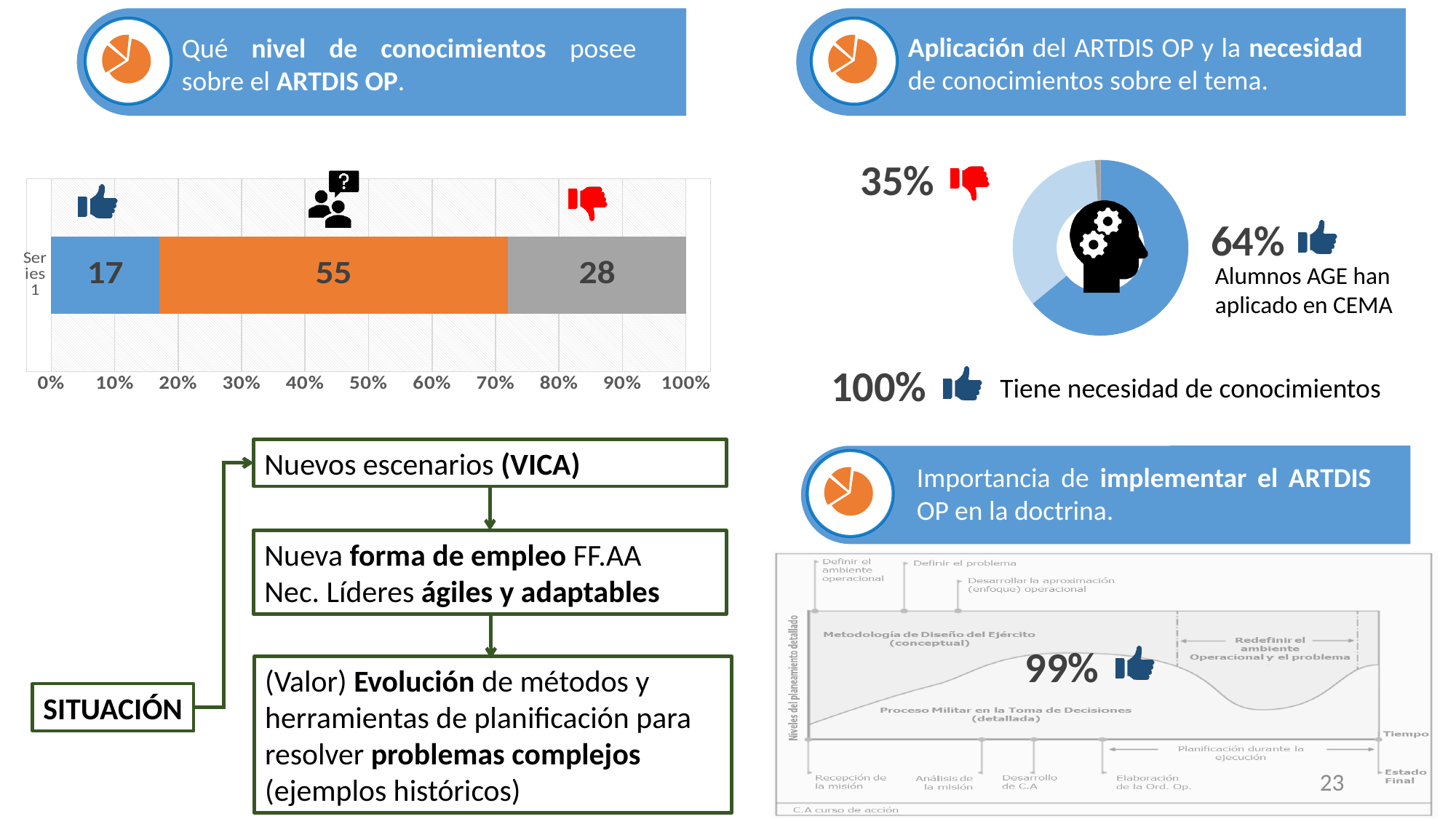
In the stacked bar chart on the left, what value is printed on the orange segment? 55 In the stacked bar chart on the left, what value is printed on the blue segment? 17 In the stacked bar chart on the left, what value is printed on the gray segment? 28 How many segments make up the stacked bar in the chart on the left? 3 In the stacked bar chart on the left, which coloured segment has the largest value? orange (55) What kind of chart is shown on the left under the heading about 'nivel de conocimientos'? stacked bar chart What is the highest tick label on the x axis of the stacked bar chart on the left? 100% In the pie chart on the right, what percentage is shown next to the thumbs-down icon? 35% In the stacked bar chart on the left, what is the difference between the orange segment and the gray segment? 27 In the stacked bar chart on the left, what is the total of the three segments? 100 In the pie chart on the right, what percentage is shown next to the thumbs-up icon for 'Alumnos AGE han aplicado en CEMA'? 64% In the stacked bar chart on the left, which coloured segment has the smallest value? blue (17)